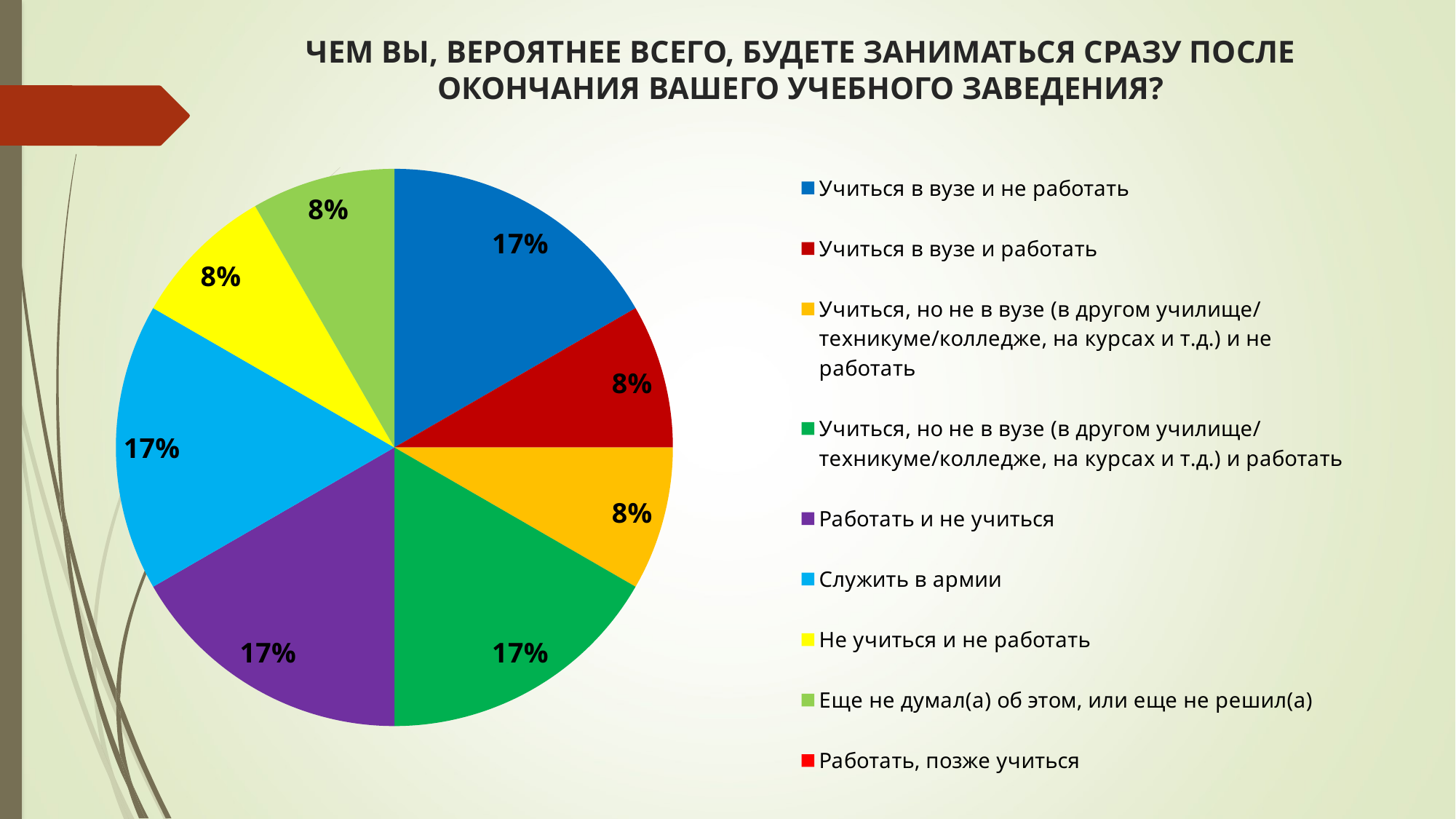
What share of the pie is labelled for "Учиться в вузе и не работать"? 17% What share of the pie is labelled for "Работать и не учиться"? 17% What share of the pie is labelled for "Служить в армии"? 17% How many slices with percentage labels are visible in the pie? 8 How many entries does the legend list? 9 What share of the pie is labelled for "Еще не думал(а) об этом, или еще не решил(а)"? 8% What kind of chart is shown on the slide? pie chart What share of the pie is labelled for "Не учиться и не работать"? 8% What is the difference between the share for "Работать и не учиться" and the share for "Учиться в вузе и работать"? 9% What share of the pie is labelled for "Учиться в вузе и работать"? 8% Which is larger: the slice for "Служить в армии" or the slice for "Не учиться и не работать"? Служить в армии What colour is the slice for "Служить в армии"? light blue